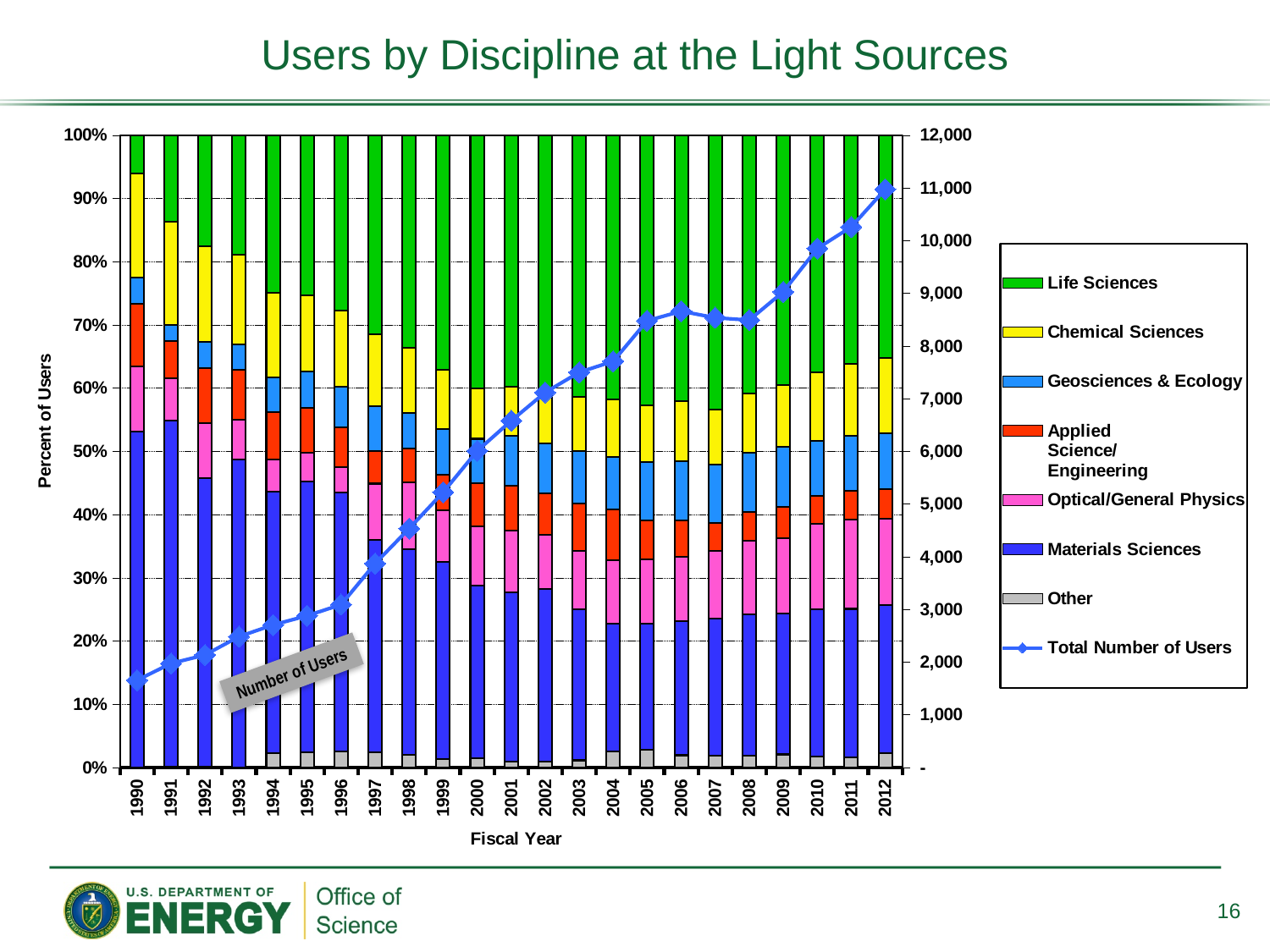
How many fiscal years are shown on the x axis? 23 Is the Materials Sciences share of users larger in 1990 or in 2012? 1990 How many entries does the legend list? 8 Is the Total Number of Users in 2005 greater or less than 8,000? greater What kind of chart is shown on the slide? Stacked bar chart with a line What colour represents Life Sciences in the chart? Green Is the Total Number of Users in 1990 greater or less than 2,000? less Which fiscal year has the highest Total Number of Users? 2012 Does the Total Number of Users line generally rise or fall from 1990 to 2012? Rise What is the title of the chart? Users by Discipline at the Light Sources Is the Total Number of Users in 2012 greater or less than 10,000? greater Which fiscal year has the lowest Total Number of Users? 1990